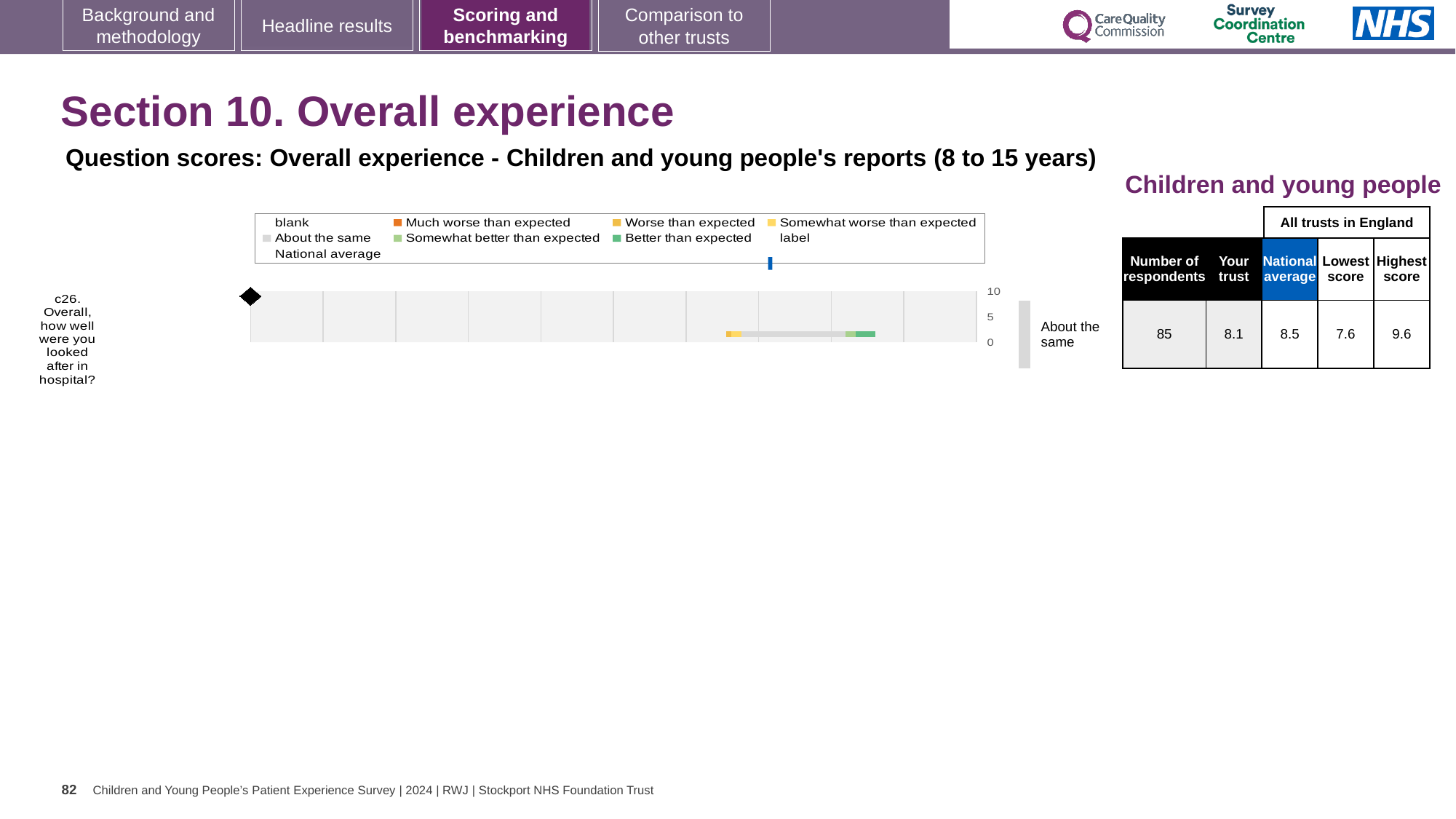
How many survey questions are plotted on the chart? 1 What kind of chart is used to show the question score for c26? bar chart What is the national average score for c26? 8.5 How many respondents answered question c26? 85 Which is larger for c26, the 'Your trust' score or the national average? National average What is the lowest score among all trusts in England for c26? 7.6 Which question is plotted on the chart? c26. Overall, how well were you looked after in hospital? What is the 'Your trust' score for c26? 8.1 Is the 'Your trust' score for c26 greater or less than 5 on the chart's axis? greater What is the highest score among all trusts in England for c26? 9.6 What benchmark category is shown next to the bar for c26? About the same What is the difference between the highest score and the lowest score for c26? 2.0